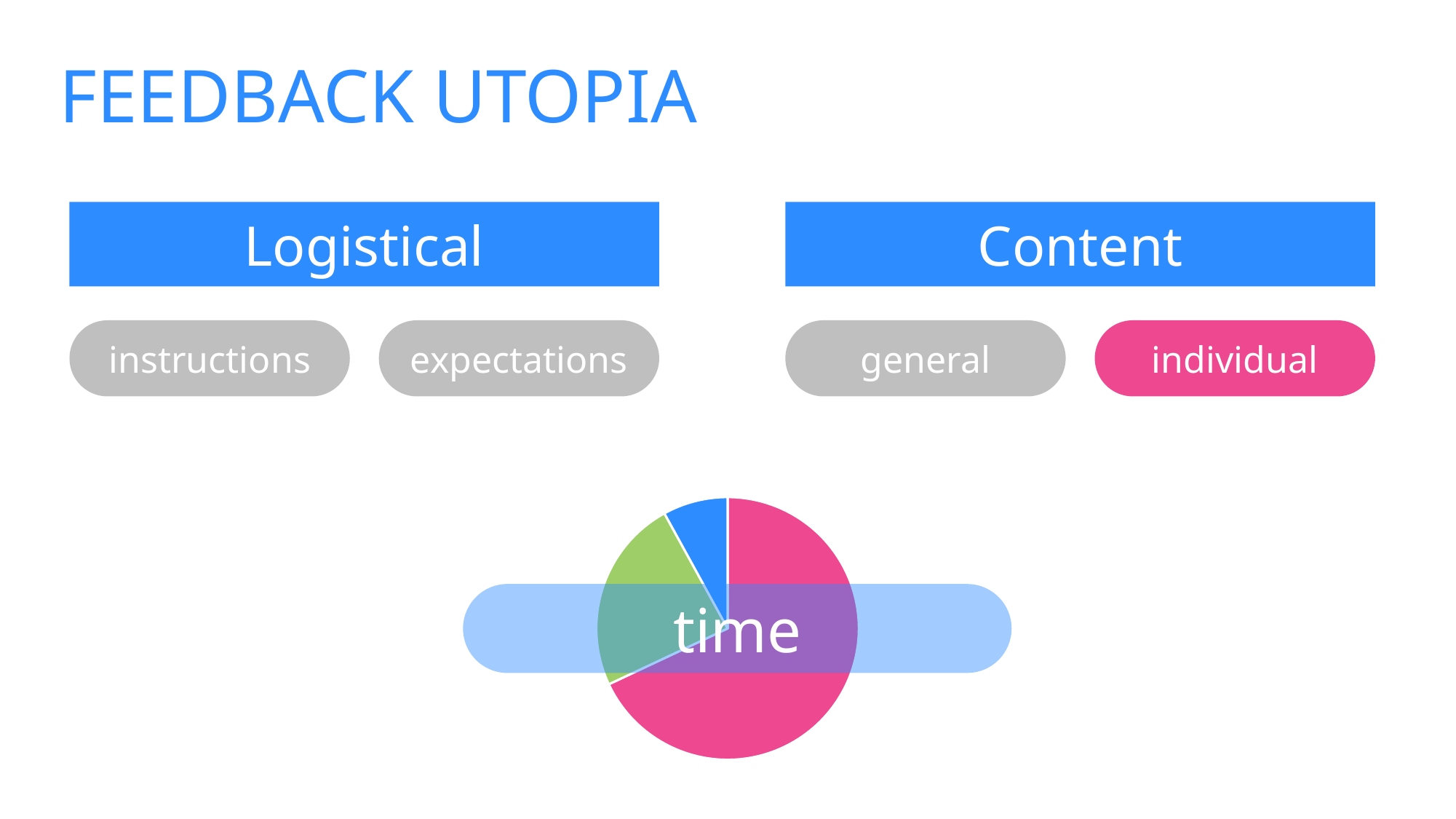
What word is written across the pie chart? time In the pie chart, which is larger, the pink slice or the green slice? pink Does the pie chart have a legend? No In the pie chart, which is smaller, the green slice or the blue slice? blue In the pie chart, which colour slice is the largest? pink What kind of chart is shown at the bottom of the slide? pie chart